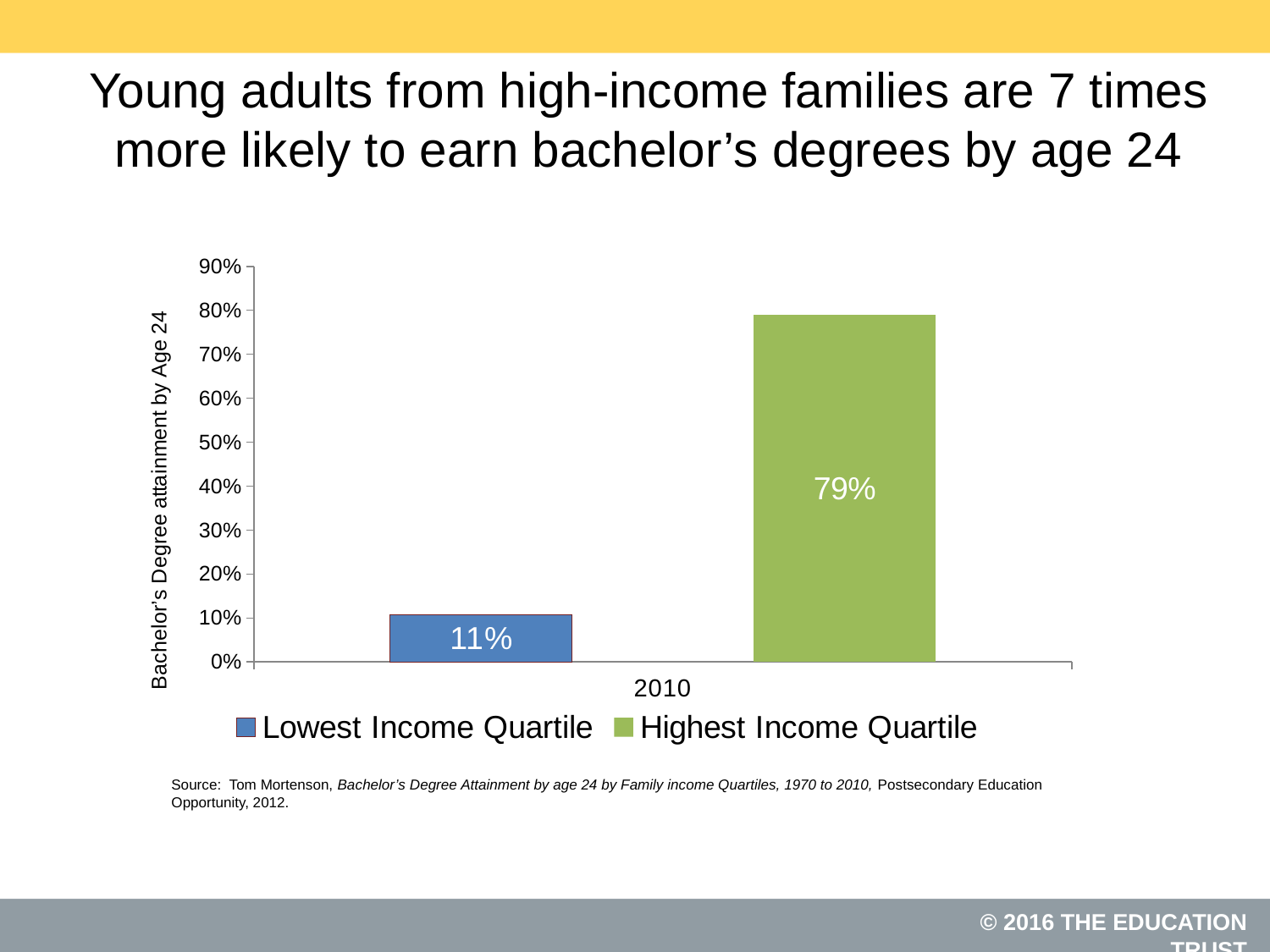
What kind of chart is shown on the slide? bar chart What is the bachelor's degree attainment by age 24 for the Highest Income Quartile in 2010? 79% Is the value for the Lowest Income Quartile greater or less than 20%? less Is the value for the Highest Income Quartile greater or less than 70%? greater What is the difference between the Highest Income Quartile and Lowest Income Quartile values? 68% What year is shown on the x axis of the chart? 2010 What is the label on the vertical axis of the chart? Bachelor's Degree attainment by Age 24 Which series has the lower value in 2010? Lowest Income Quartile Is the value for the Lowest Income Quartile larger or smaller than the value for the Highest Income Quartile? smaller Which series has the higher value in 2010? Highest Income Quartile How many series does the legend list? 2 What is the bachelor's degree attainment by age 24 for the Lowest Income Quartile in 2010? 11%